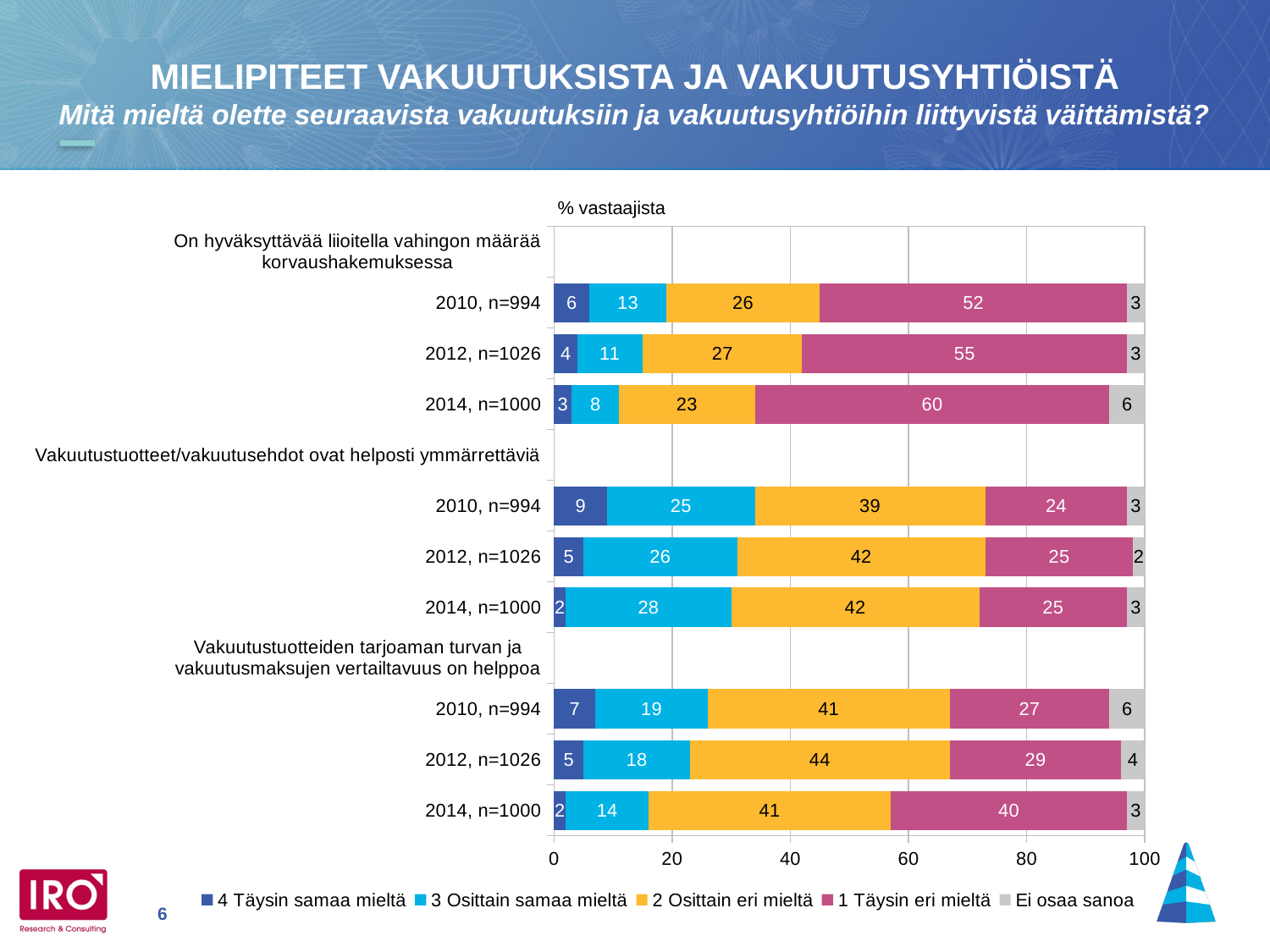
What is the value for "3 Osittain samaa mieltä" in the 2010, n=994 row under "Vakuutustuotteet/vakuutusehdot ovat helposti ymmärrettäviä"? 25 What is the value for "2 Osittain eri mieltä" in the 2012, n=1026 row under "Vakuutustuotteiden tarjoaman turvan ja vakuutusmaksujen vertailtavuus on helppoa"? 44 What kind of chart is shown on the slide? Stacked bar chart Across the three years under "Vakuutustuotteiden tarjoaman turvan ja vakuutusmaksujen vertailtavuus on helppoa", which year has the lowest value for "3 Osittain samaa mieltä"? 2014, n=1000 Under "Vakuutustuotteet/vakuutusehdot ovat helposti ymmärrettäviä", is the "2 Osittain eri mieltä" value larger for 2010, n=994 or for 2012, n=1026? 2012, n=1026 What is the difference between the "1 Täysin eri mieltä" values for 2014, n=1000 and 2010, n=994 under "Vakuutustuotteiden tarjoaman turvan ja vakuutusmaksujen vertailtavuus on helppoa"? 13 What is the value for "1 Täysin eri mieltä" in the 2014, n=1000 row under "On hyväksyttävää liioitella vahingon määrää korvaushakemuksessa"? 60 Across the three years under "On hyväksyttävää liioitella vahingon määrää korvaushakemuksessa", which year has the highest value for "1 Täysin eri mieltä"? 2014, n=1000 How does the "4 Täysin samaa mieltä" value change from 2010 to 2014 under "Vakuutustuotteet/vakuutusehdot ovat helposti ymmärrettäviä"? It falls How many series does the legend list? 5 What is the total of the "4 Täysin samaa mieltä" and "3 Osittain samaa mieltä" values for 2010, n=994 under "On hyväksyttävää liioitella vahingon määrää korvaushakemuksessa"? 19 What label is shown above the chart to indicate the unit of the values? % vastaajista